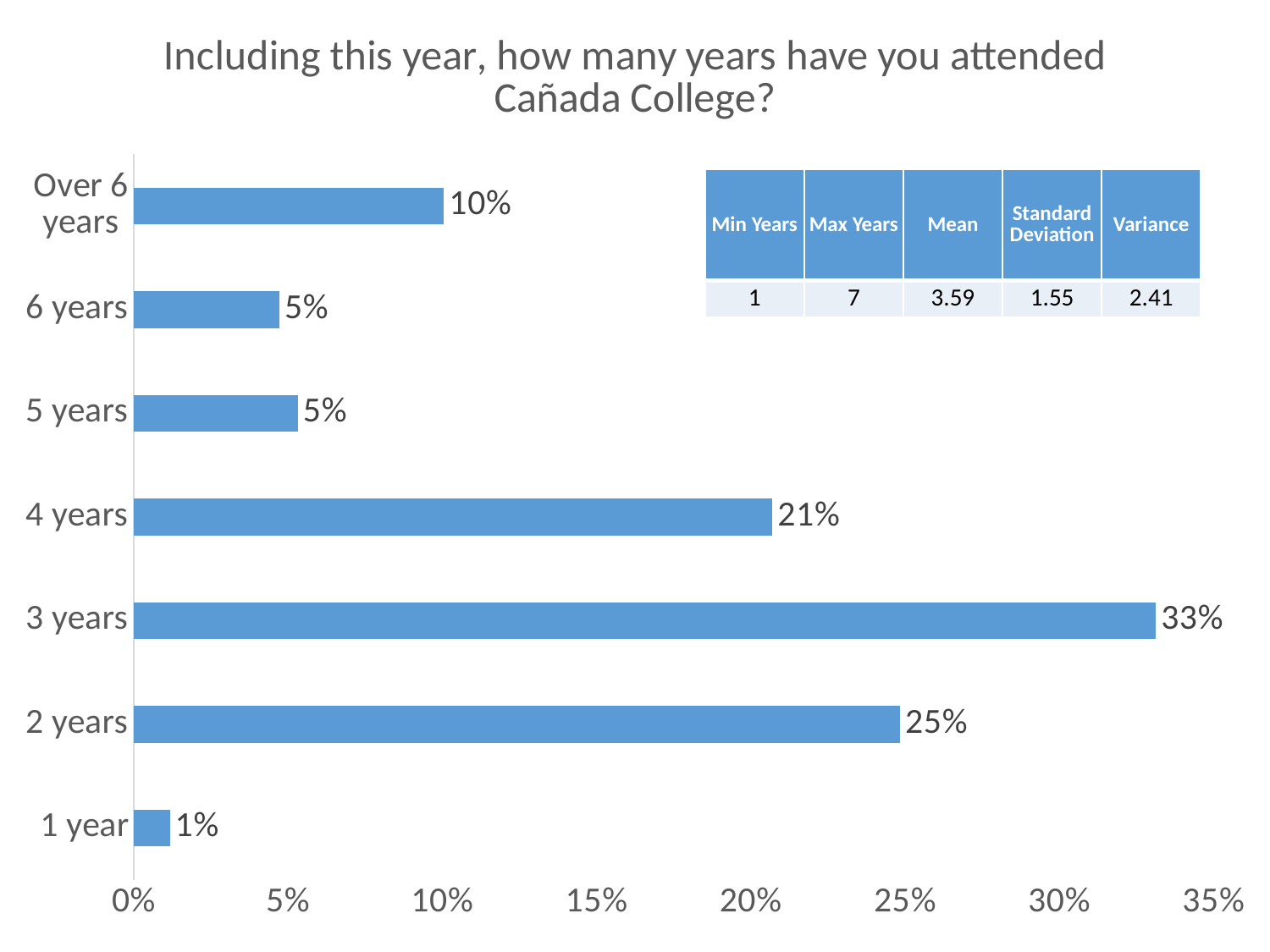
How many categories are shown on the chart? 7 What is the difference in percentage points between the 3 years and 2 years categories? 8% What percentage of respondents have attended for 1 year? 1% Which category has the lowest percentage of respondents? 1 year Which category has the highest percentage of respondents? 3 years What is the mean number of years shown in the table on the slide? 3.59 Which category has a larger share of respondents, 4 years or over 6 years? 4 years What kind of chart is shown on the slide? bar chart What percentage of respondents have attended Cañada College for 3 years? 33% What is the title of the chart? Including this year, how many years have you attended Cañada College? What percentage of respondents have attended for over 6 years? 10% Is the value for 2 years greater or less than 20%? greater